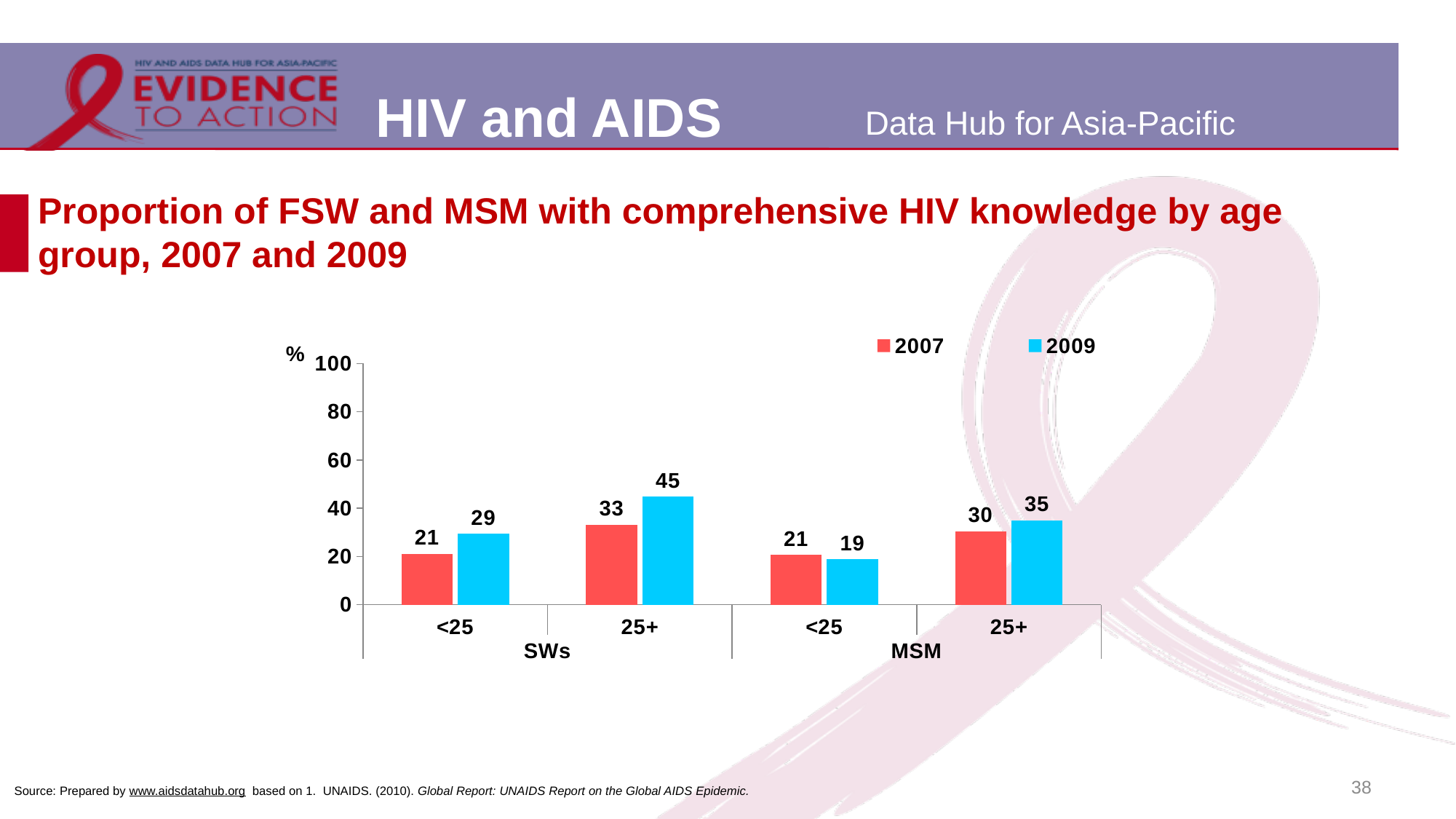
What kind of chart is shown on the slide? Bar chart Which group and age category has the lowest 2009 value? MSM <25 What is the 2007 value for MSM aged <25? 21 What is the 2009 value for MSM aged 25+? 35 What is the difference between the 2007 and 2009 values for MSM aged <25? 2 What colour are the 2009 bars? Blue Is the 2007 value for MSM aged 25+ greater or less than 20? greater Which is larger for SWs aged <25: the 2007 value or the 2009 value? 2009 How many series does the legend list? 2 What is the difference between the 2009 and 2007 values for SWs aged 25+? 12 What is the 2009 value for SWs aged 25+? 45 Which group and age category has the highest 2009 value? SWs 25+